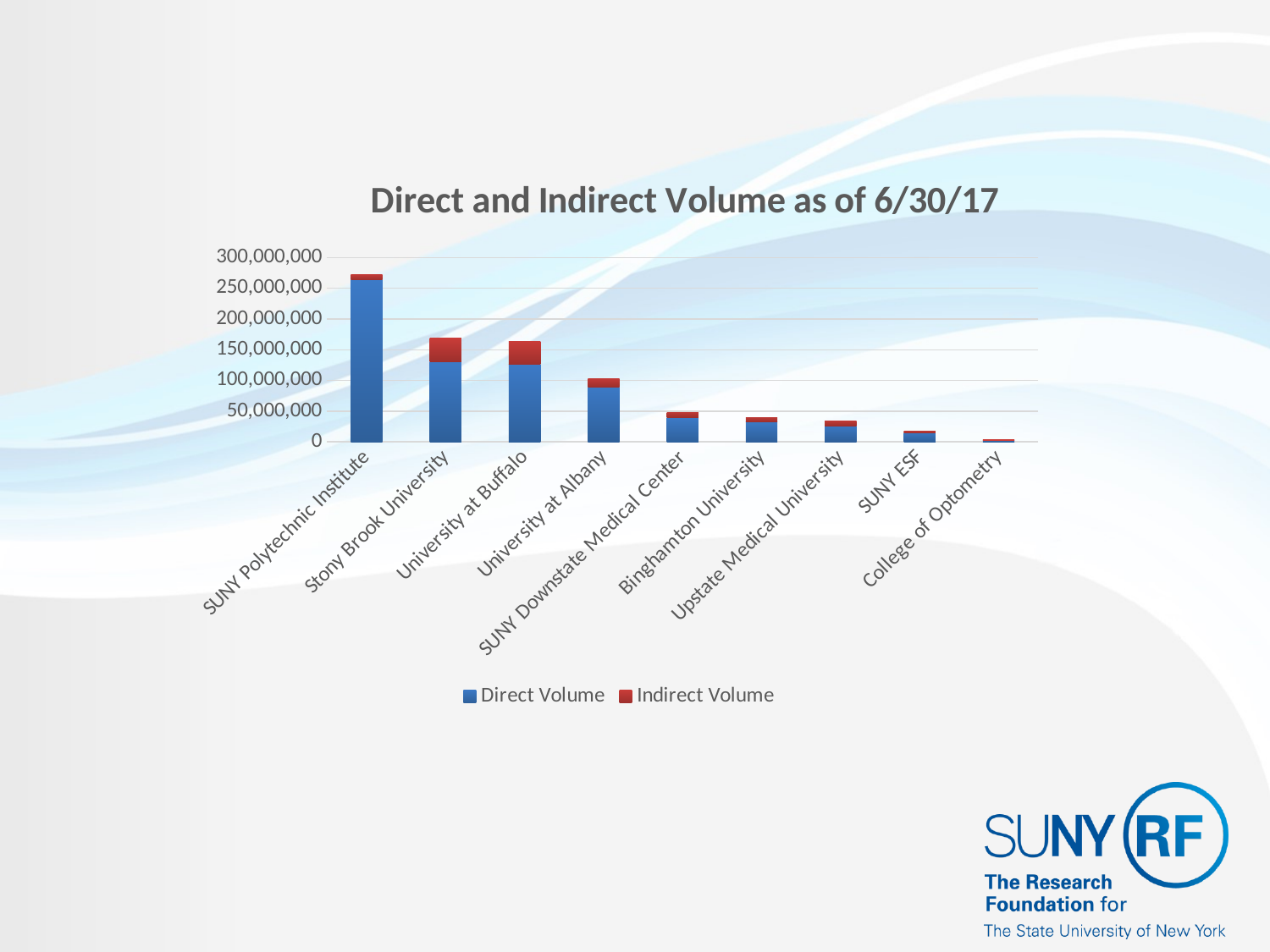
Which institution has the highest total volume? SUNY Polytechnic Institute Is the total volume for Binghamton University greater or less than 50,000,000? less Which has a larger total volume, SUNY Polytechnic Institute or Stony Brook University? SUNY Polytechnic Institute What is the title of the chart? Direct and Indirect Volume as of 6/30/17 Is the total volume for Stony Brook University greater or less than 150,000,000? greater Which institution has the lowest total volume? College of Optometry Is the Direct Volume for University at Albany greater or less than 100,000,000? less Do the total volumes rise or fall moving from left to right along the x axis? fall How many series does the legend list? 2 How many institutions are shown on the x axis? 9 What kind of chart is shown on the slide? Stacked bar chart